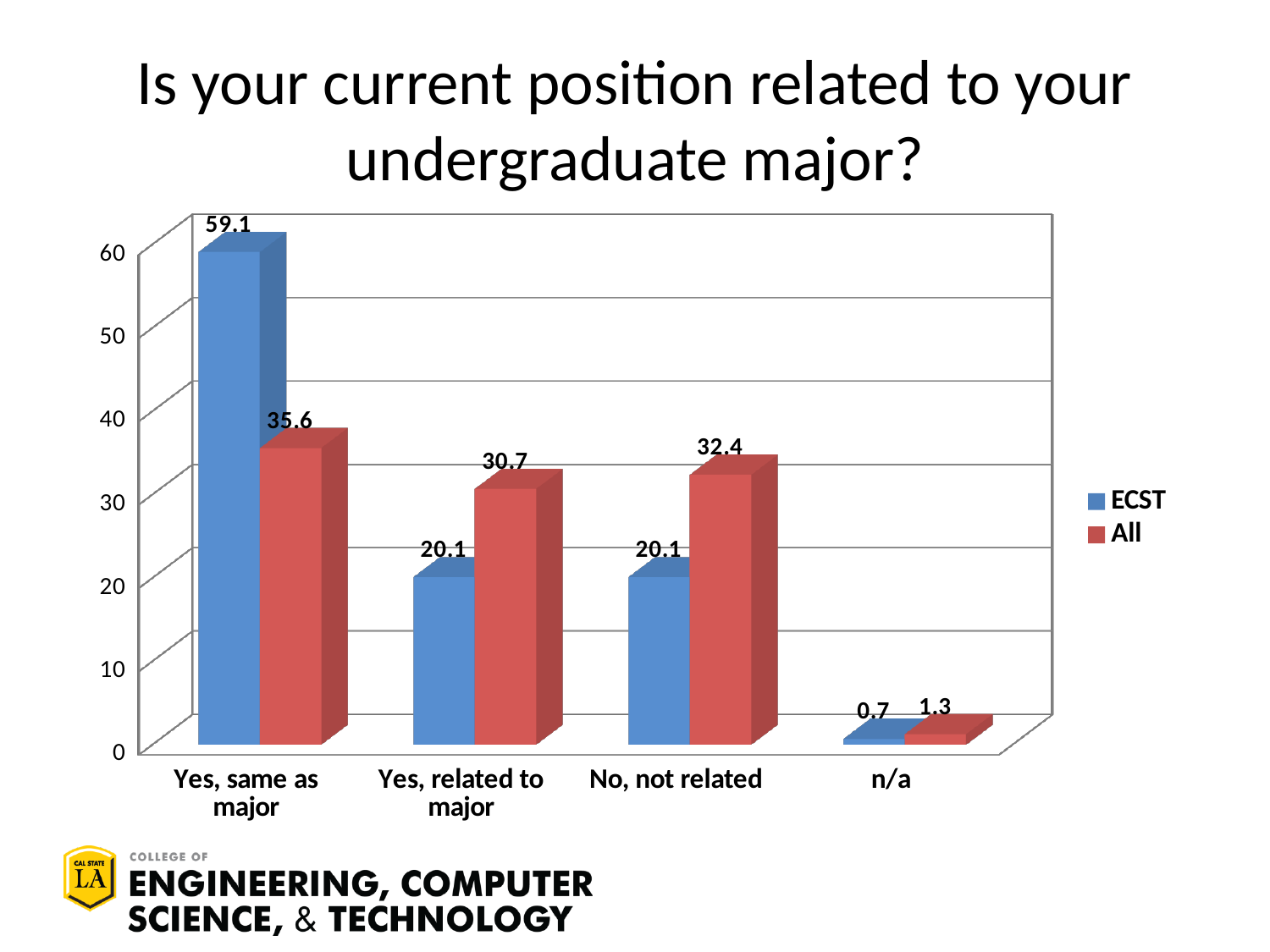
How many categories are shown on the x axis? 4 What is the title of the chart? Is your current position related to your undergraduate major? Which category has the highest ECST value? Yes, same as major What is the ECST value for "Yes, same as major"? 59.1 What is the All value for "No, not related"? 32.4 What kind of chart is shown on the slide? Bar chart What is the All value for "Yes, related to major"? 30.7 How many series does the legend list? 2 What is the ECST value for "n/a"? 0.7 What is the difference between the ECST and All values for "Yes, same as major"? 23.5 For "No, not related", which series has the larger value, ECST or All? All Which category has the lowest All value? n/a